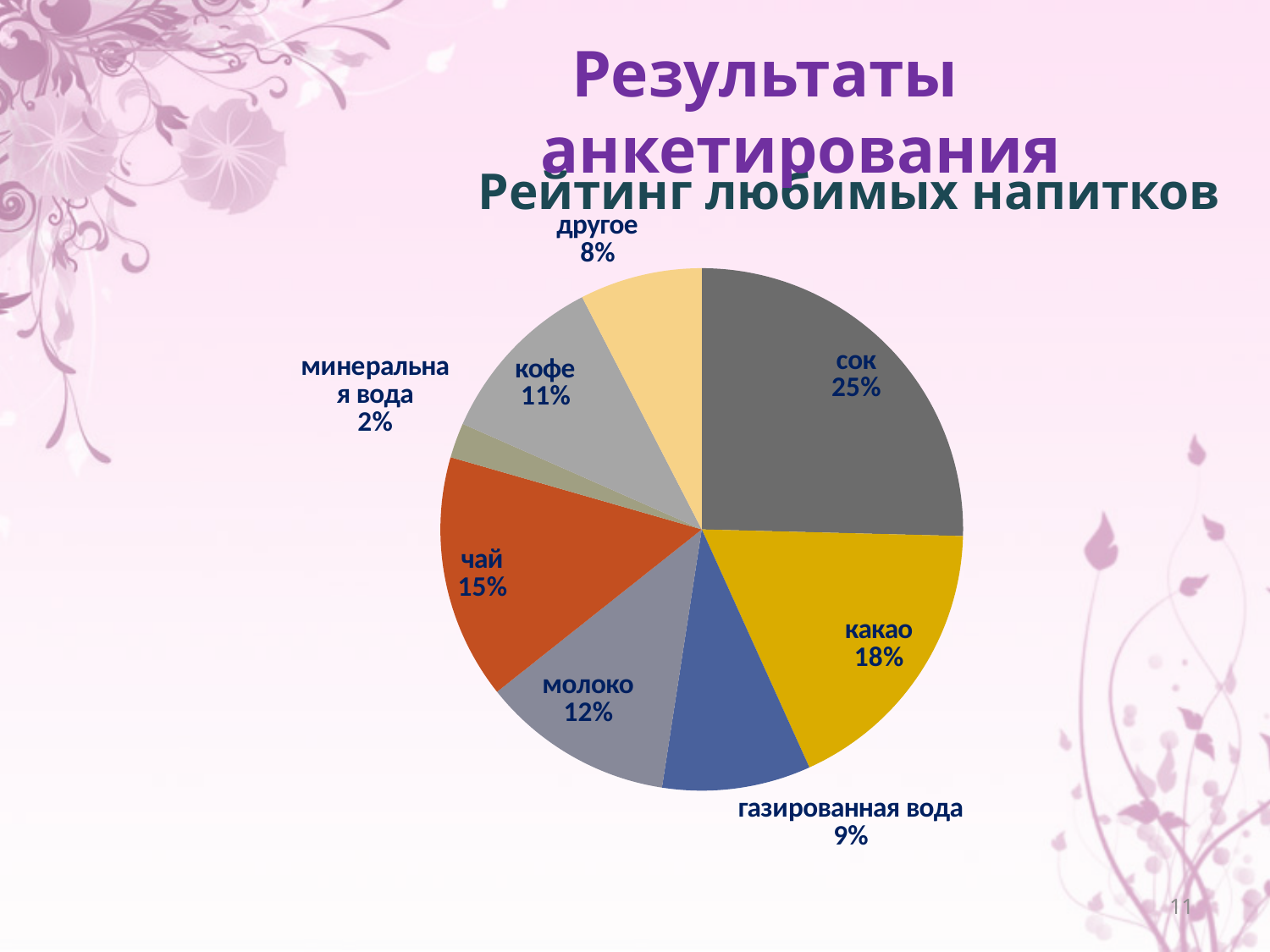
What is the title of the chart? Рейтинг любимых напитков What kind of chart is shown on the slide? pie chart What is the difference in percentage points between чай and газированная вода? 6 What share of the pie does чай have? 15% Which has a larger share, молоко or кофе? молоко What share of the pie does сок have? 25% What share of the pie does минеральная вода have? 2% What is the difference in percentage points between сок and какао? 7 Which drink has the largest slice of the pie? сок How many slices does the pie chart have? 8 Which drink has the smallest slice of the pie? минеральная вода